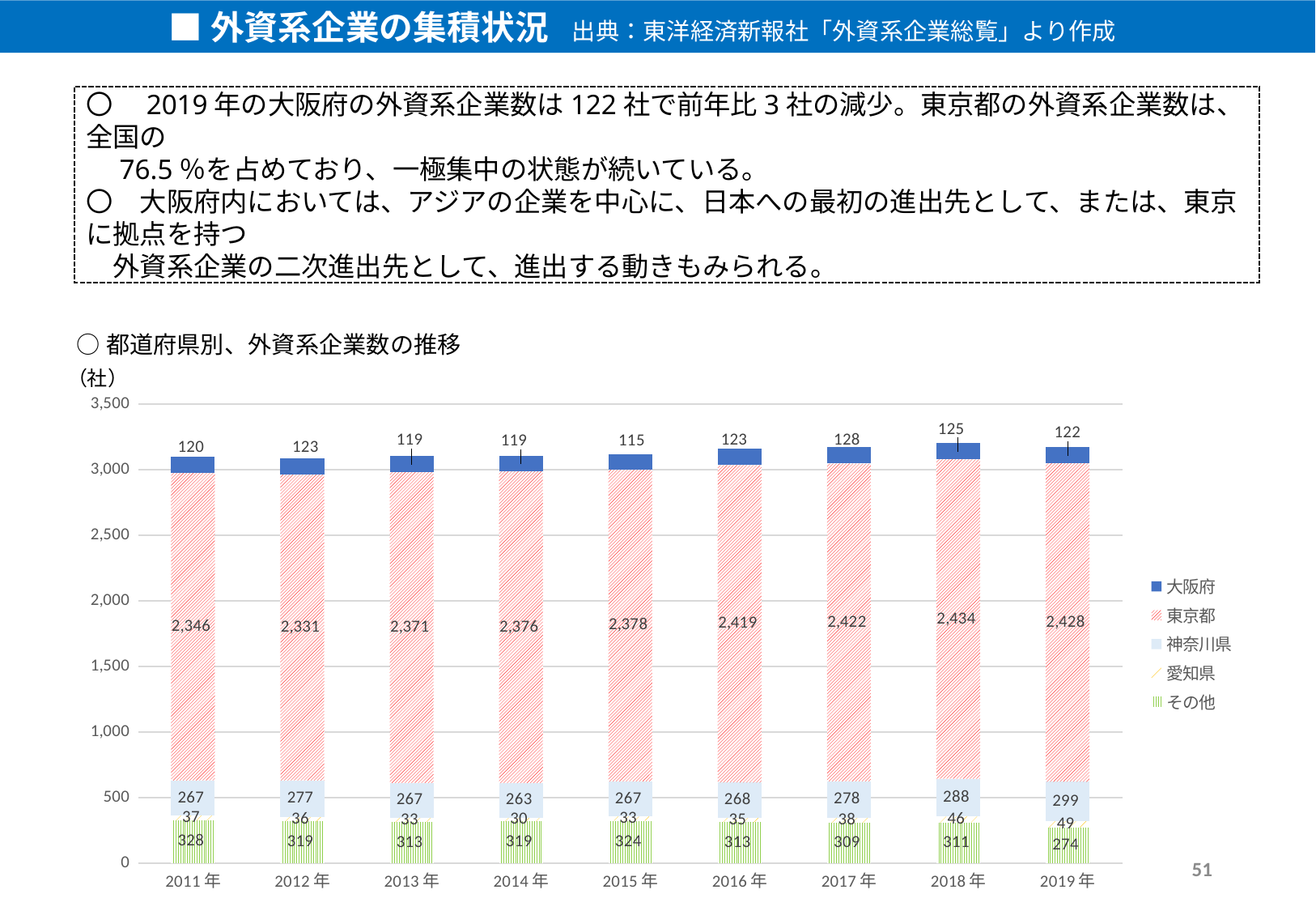
How many years are shown on the x axis? 9 What is the value for 東京都 in 2018年? 2,434 In which year is the value for 大阪府 the lowest? 2015年 What is the value for 大阪府 in 2019年? 122 What unit is shown above the y axis? (社) What is the total of the stacked bar for 2019年? 3,172 What is the difference between the 東京都 value in 2019年 and in 2011年? 82 What is the value for その他 in 2019年? 274 Which year has the larger value for 神奈川県, 2011年 or 2019年? 2019年 In which year is the value for 大阪府 the highest? 2017年 How many series does the legend list? 5 What kind of chart is shown? Stacked bar chart